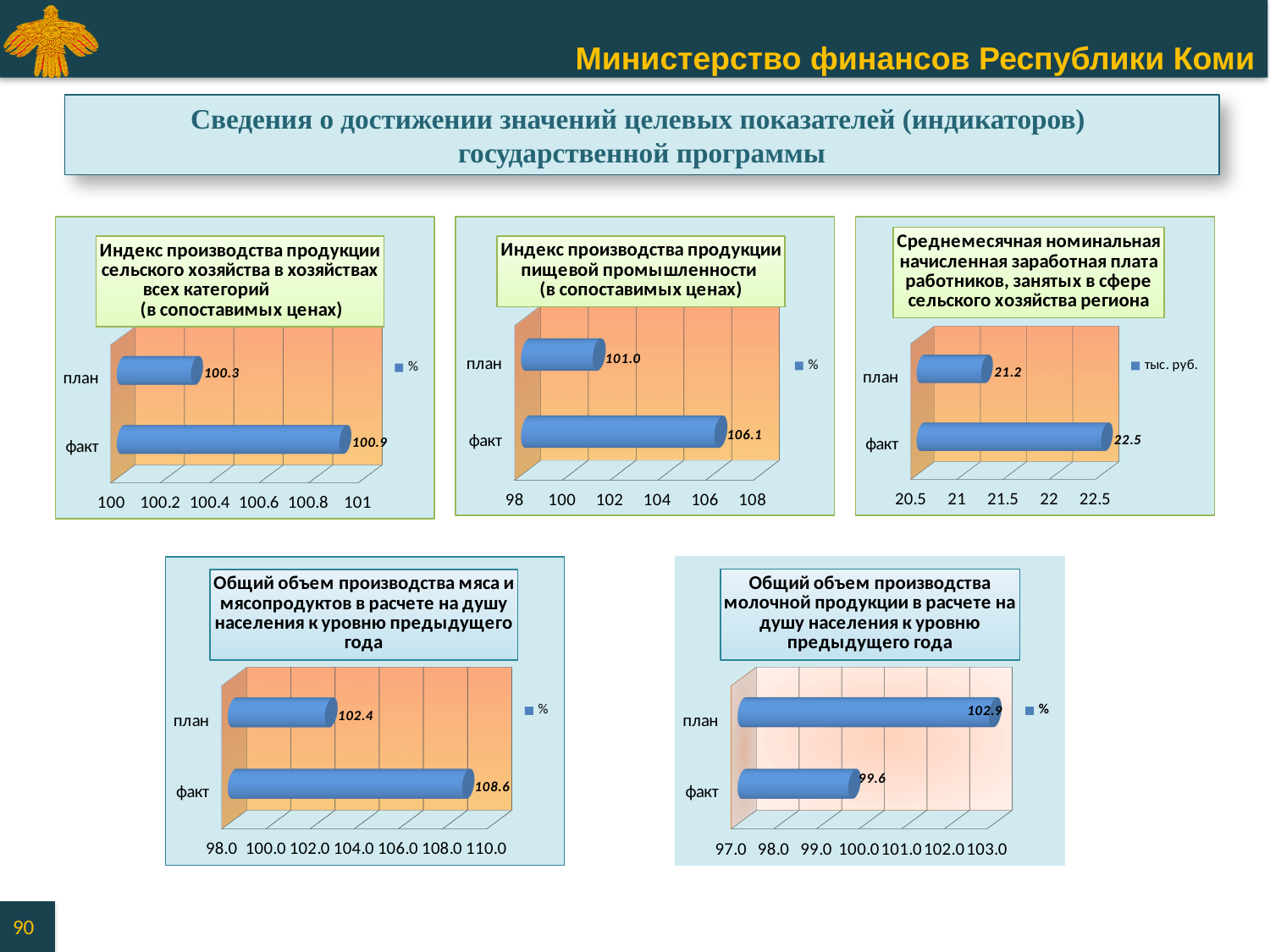
In the bottom-left chart (meat and meat products production per capita), what is the value for план? 102.4 In the bottom-right chart (dairy production per capita), what is the value for факт? 99.6 In the bottom-left chart (meat and meat products production per capita), which category has the highest value? факт In the top-right chart (average monthly nominal wage in agriculture), what unit does the legend show? тыс. руб. In the top-left chart (agricultural production index), what is the value for план? 100.3 How many categories are shown in the top-right chart (average monthly nominal wage in agriculture)? 2 In the top-middle chart (food industry production index), what is the difference between факт and план? 5.1 What type of chart is the bottom-right chart (dairy production per capita)? bar chart In the bottom-right chart (dairy production per capita), which category has the lowest value? факт In the top-right chart (average monthly nominal wage in agriculture), what is the value for факт? 22.5 In the top-left chart (agricultural production index), what is the value for факт? 100.9 In the top-middle chart (food industry production index), which is larger, план or факт? факт